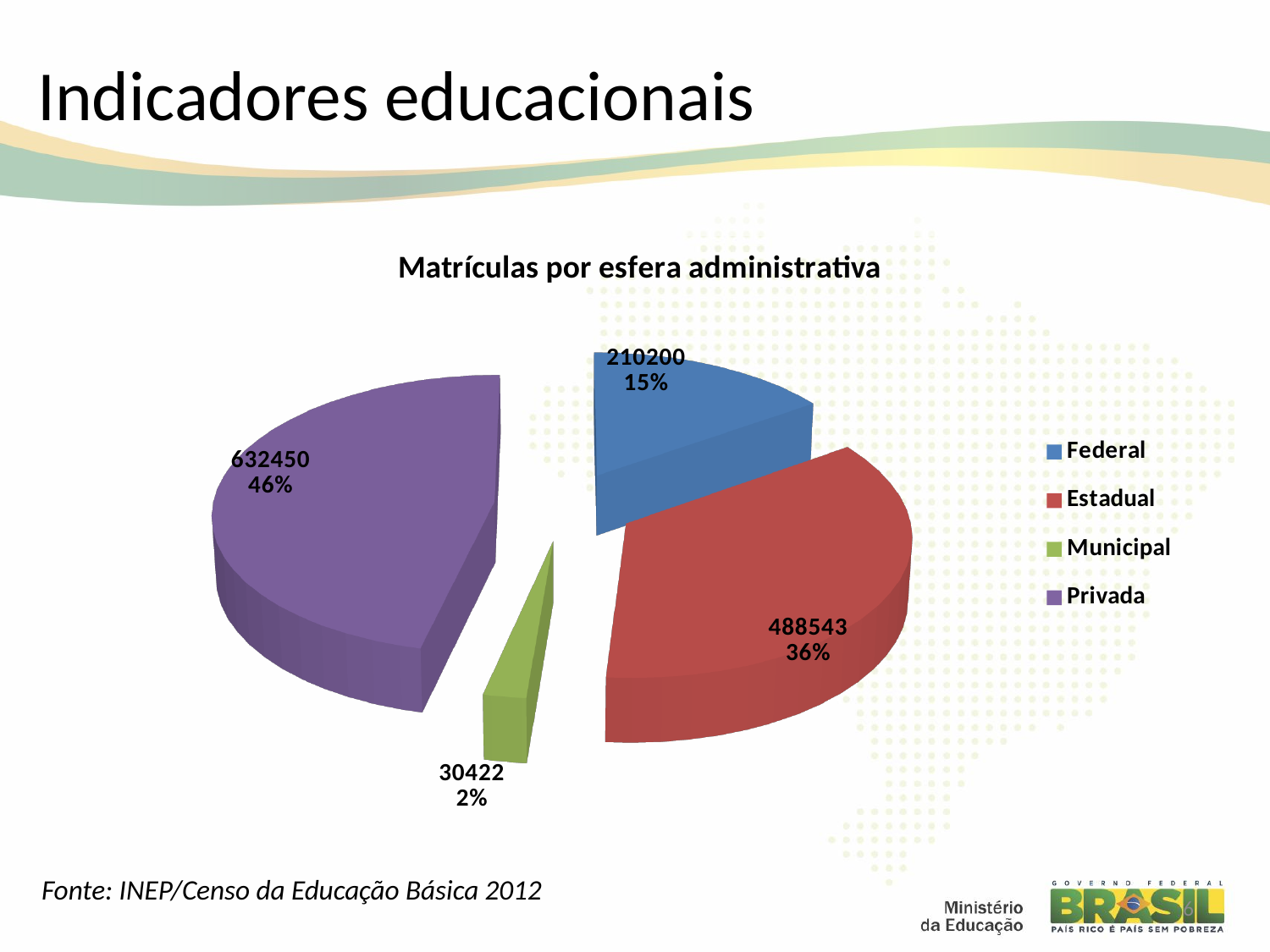
How many categories does the legend list? 4 Which category has the smallest share of the pie? Municipal What kind of chart is shown on the slide? pie chart What is the value for Municipal? 30422 What is the difference between the values for Privada and Estadual? 143907 Which is larger, the value for Federal or the value for Municipal? Federal Which category has the largest share of the pie? Privada What is the title of the chart? Matrículas por esfera administrativa What percentage share does Estadual have? 36% What is the value for Estadual? 488543 What is the value for Privada? 632450 What is the value for Federal? 210200